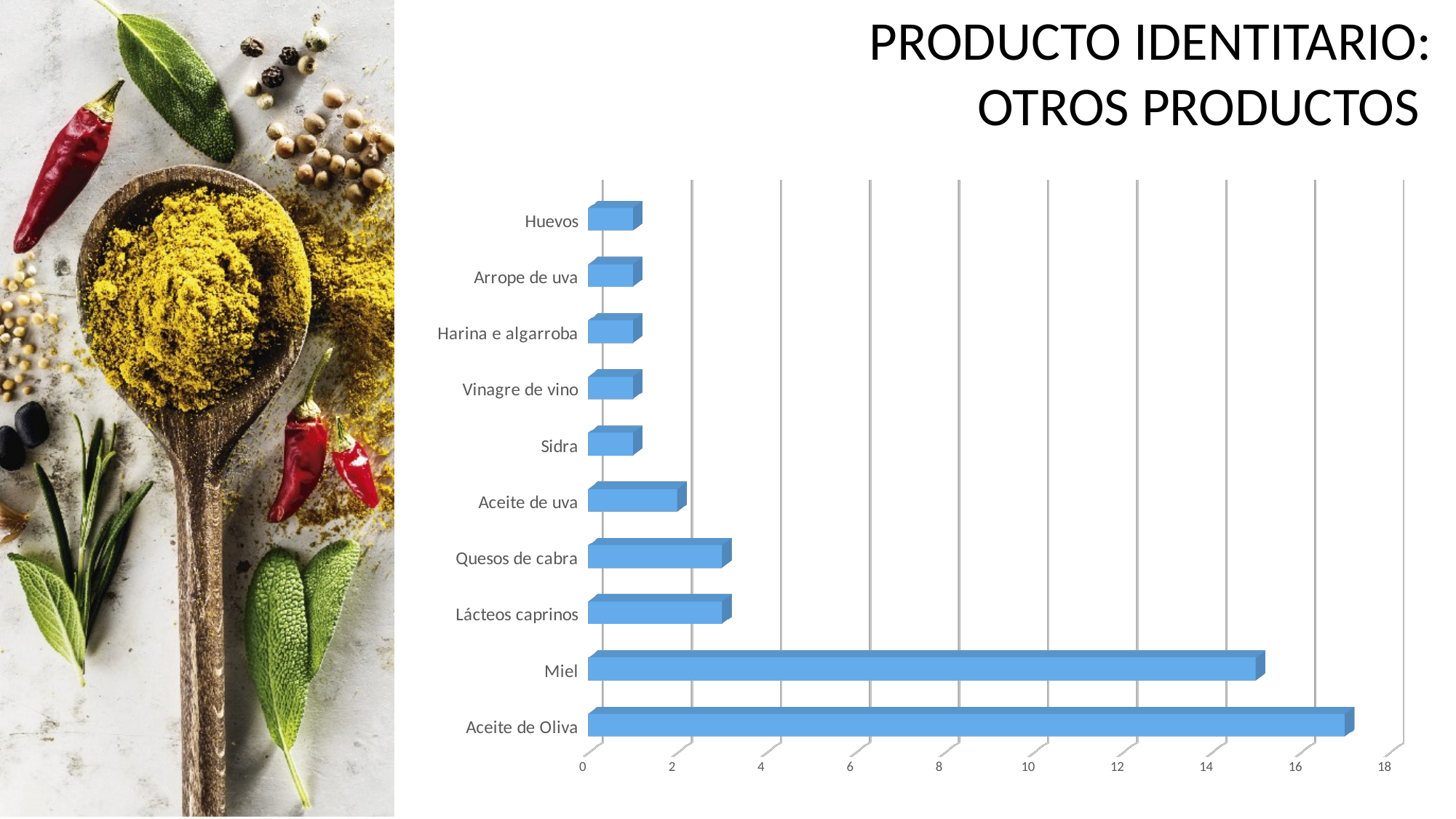
Is the value for Miel greater or less than 14? greater Which has the larger value, Miel or Quesos de cabra? Miel Is the value for Quesos de cabra greater or less than 4? less Is the value for Huevos greater or less than 2? less What is the title of the slide containing the chart? PRODUCTO IDENTITARIO: OTROS PRODUCTOS What kind of chart is shown on the slide? bar chart Which product has the highest value in the chart? Aceite de Oliva Which has the larger value, Aceite de uva or Huevos? Aceite de uva What is the highest value shown on the horizontal axis of the chart? 18 Which has the larger value, Aceite de Oliva or Miel? Aceite de Oliva How many product categories are plotted in the chart? 10